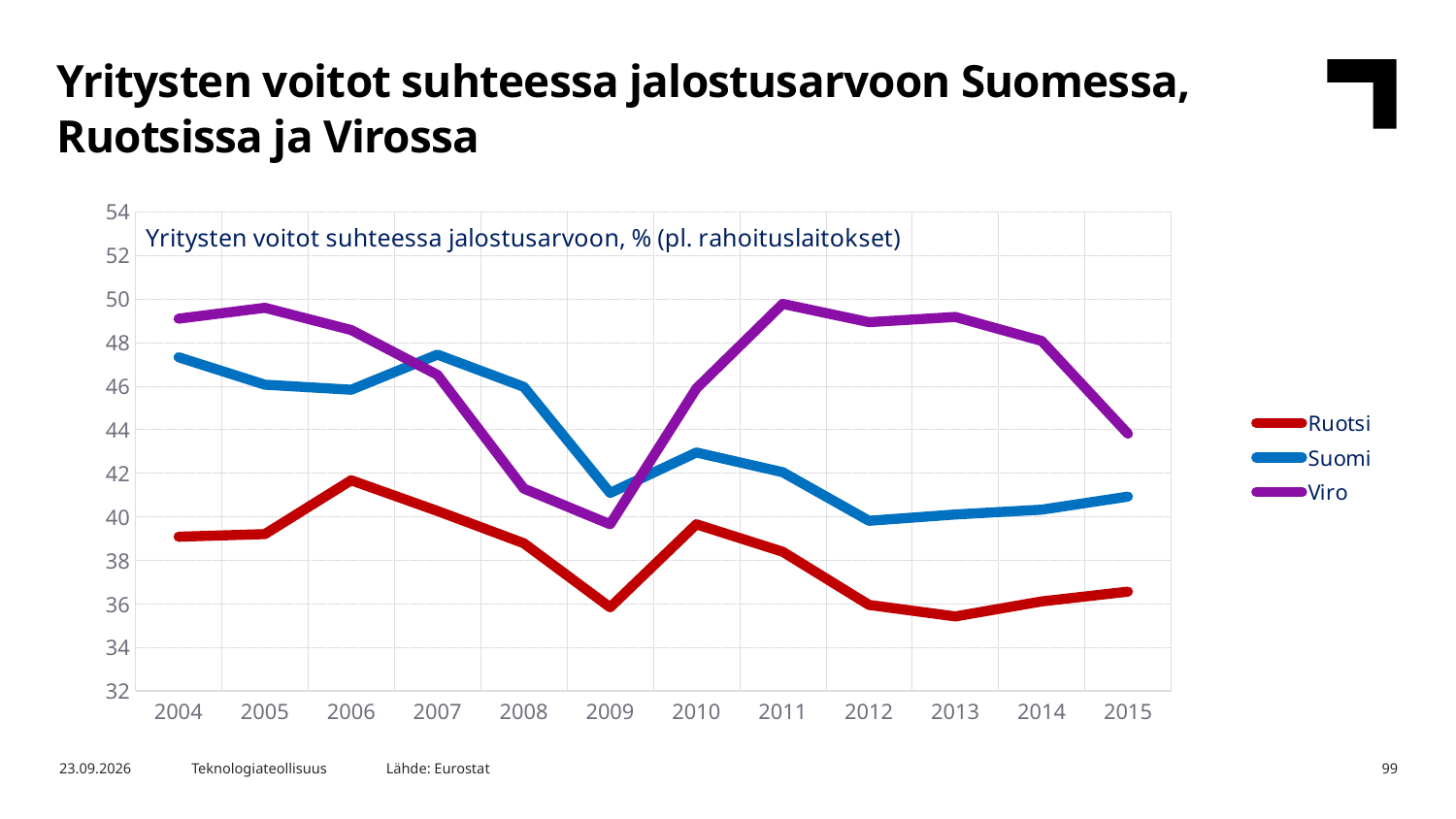
How many series does the legend list? 3 Is the value for Ruotsi in 2009 greater or less than 38? less Is the value for Suomi in 2004 greater or less than 46? greater In which year does the Ruotsi line reach its highest value? 2006 In which year does the Viro line reach its lowest value? 2009 Does the Suomi line rise or fall overall from 2004 to 2012? Fall In 2015, which is higher: Viro or Suomi? Viro What type of chart is shown on the slide? Line chart How many years are shown on the x axis? 12 Is the value for Viro in 2011 greater or less than 48? greater Which series has the highest value in 2015? Viro Which series has the lowest value in 2004? Ruotsi